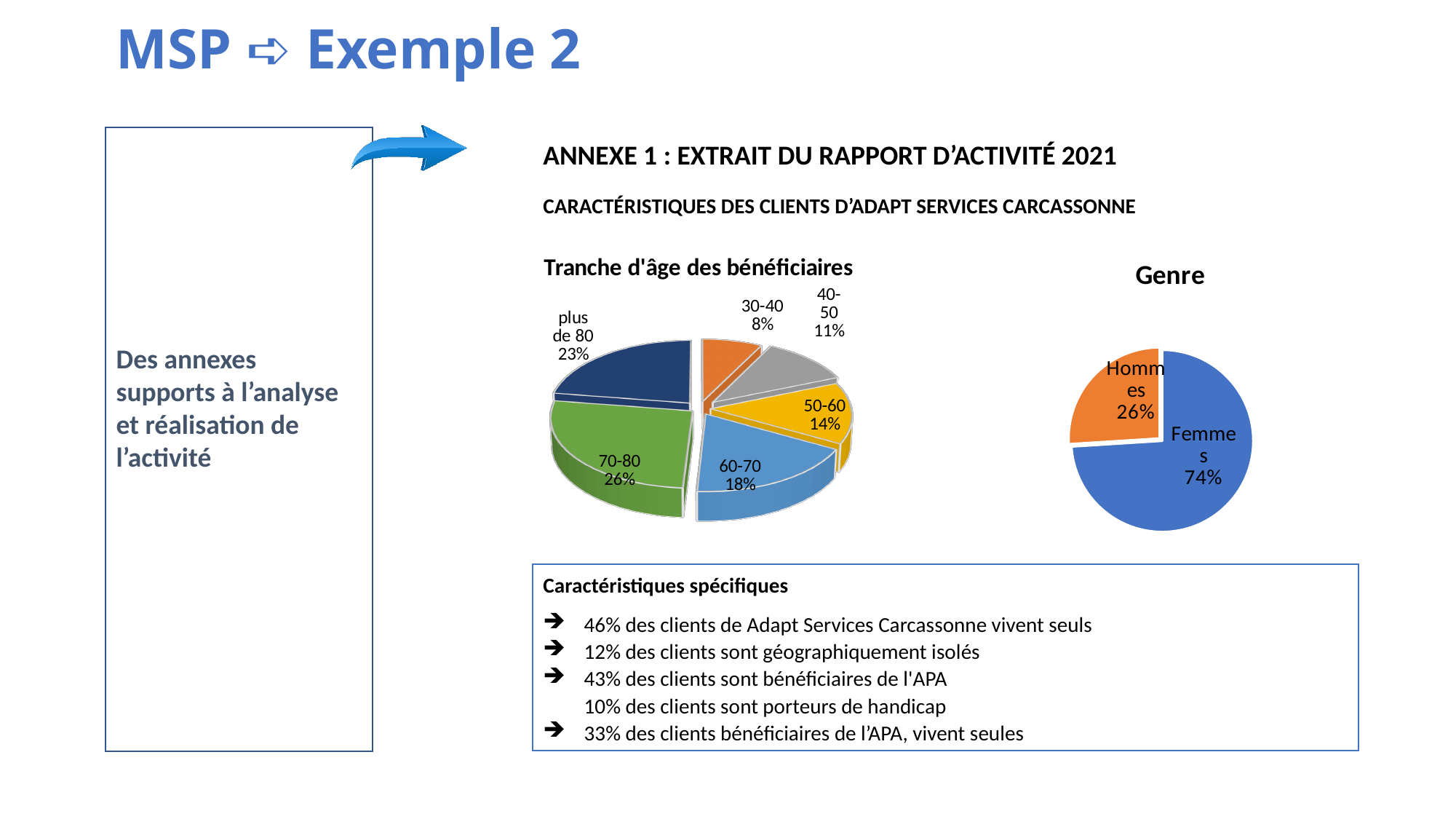
In the 'Tranche d'âge des bénéficiaires' chart, what share do the 70-80 beneficiaries represent? 26% In the 'Genre' chart, what is the difference between the Femmes share and the Hommes share? 48% In the 'Tranche d'âge des bénéficiaires' chart, which age group has the smallest share? 30-40 In the 'Tranche d'âge des bénéficiaires' chart, how many age groups are shown? 6 In the 'Genre' chart, what share do Femmes represent? 74% In the 'Tranche d'âge des bénéficiaires' chart, what is the value for 'plus de 80'? 23% In the 'Genre' chart, what share do Hommes represent? 26% In the 'Tranche d'âge des bénéficiaires' chart, which is larger: the 40-50 share or the 30-40 share? 40-50 In the 'Tranche d'âge des bénéficiaires' chart, which age group has the largest share? 70-80 What kind of chart is the 'Tranche d'âge des bénéficiaires' chart? Pie chart In the 'Tranche d'âge des bénéficiaires' chart, what is the difference between the 60-70 share and the 50-60 share? 4% In the 'Genre' chart, what colour is the Femmes slice? Blue